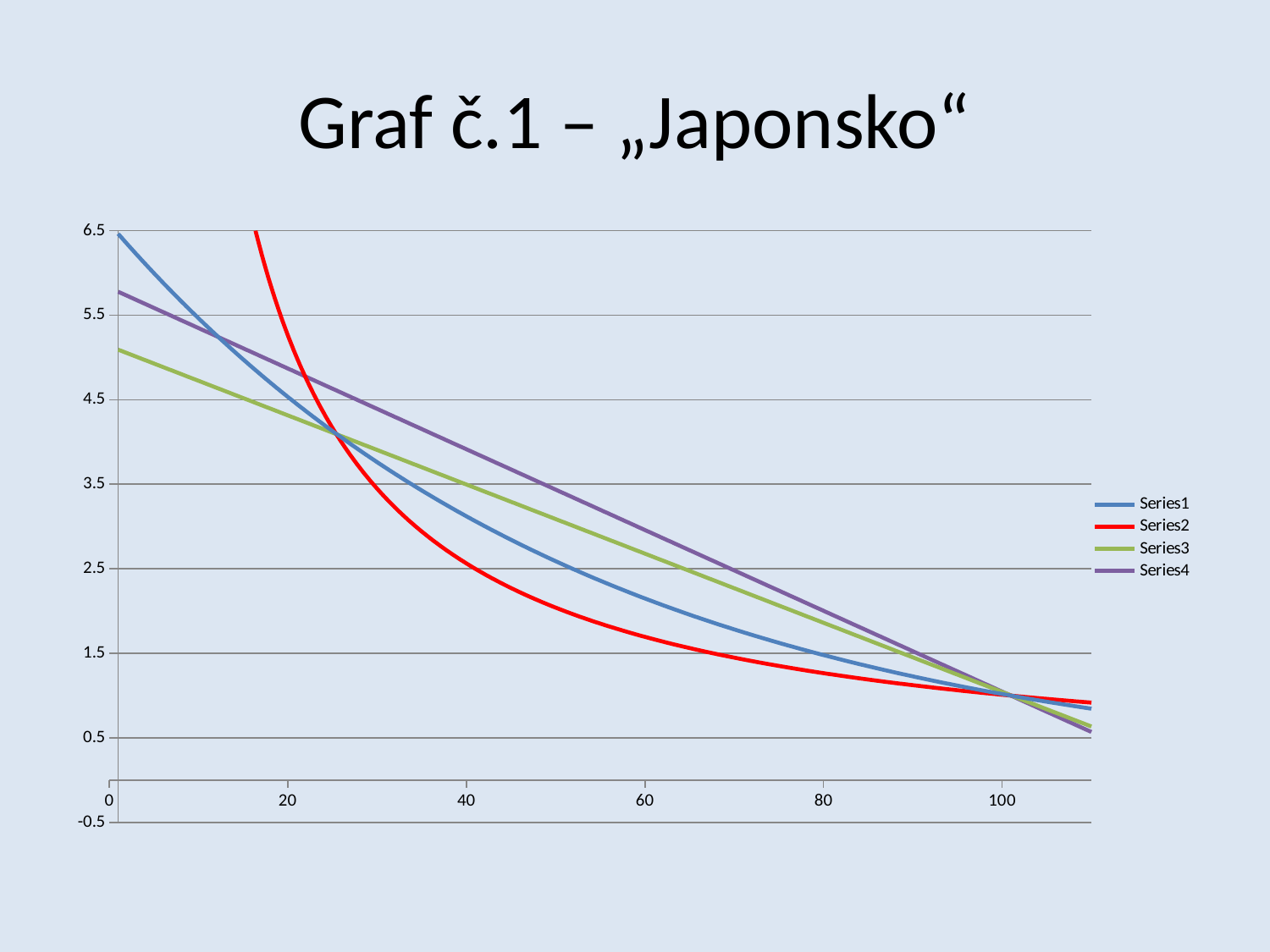
Do the values of Series4 rise or fall along the x axis? fall How many series does the legend list? 4 Is the value of Series1 at x = 0 greater or less than 5.5? greater At x = 60, which has the larger value, Series4 or Series2? Series4 Is the value of Series2 at x = 80 greater or less than 1.5? less Is the value of Series4 at x = 60 greater or less than 2.5? greater What is the title of the chart? Graf č.1 – „Japonsko“ What kind of chart is shown on the slide? line chart What colour is the line for Series2? red Do the values of Series1 rise or fall as x increases? fall Which series has the lowest value at x = 60? Series2